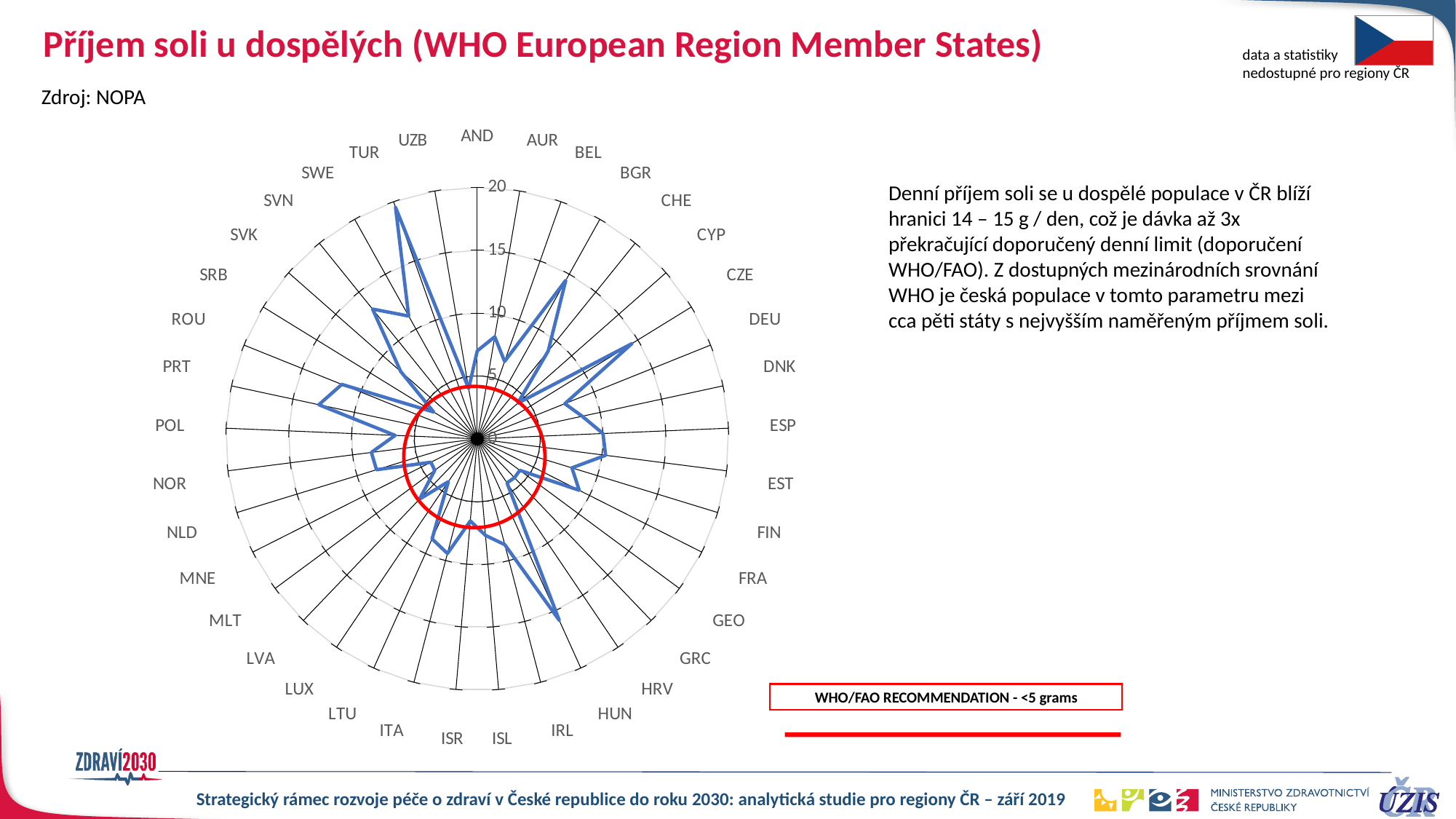
Which has the larger value, TUR or CZE? TUR How many countries are plotted on the radar chart? 37 What kind of chart is shown on the slide? radar chart What is the title of the chart on the slide? Příjem soli u dospělých (WHO European Region Member States) Which country has the highest salt intake value on the radar chart? TUR What does the red circle on the radar chart represent? WHO/FAO recommendation - <5 grams What is the highest tick value shown on the radial axis of the chart? 20 Is the value for HUN greater or less than 10? greater Is the value for BGR greater or less than 10? greater Is the value for CZE greater or less than 10? greater